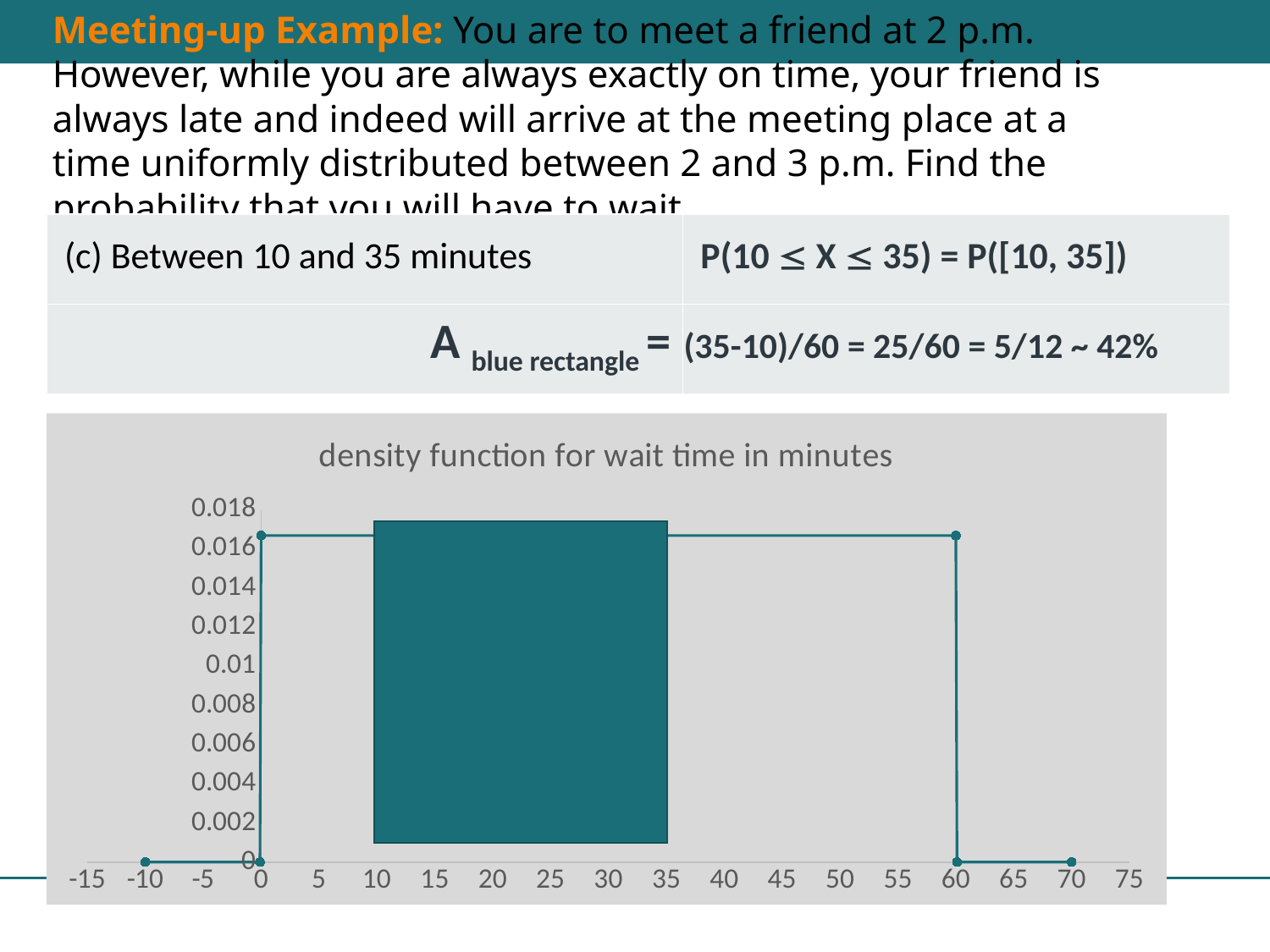
What is the highest tick label on the y axis? 0.018 Which is larger, the density value at x = 20 or at x = 65? x = 20 What kind of chart is shown on the slide? line chart What is the density value at x = 70? 0 What is the lowest tick label on the x axis? -15 Does the density value rise or fall as x goes from 60 to 70? fall What is the density value at x = -10? 0 Is the density value at x = 20 greater or less than 0.018? less Between which two x-axis values does the shaded rectangle extend? 10 and 35 How many tick labels are shown on the x axis? 19 Is the density value at x = 30 greater or less than 0.01? greater What is the title of the chart? density function for wait time in minutes